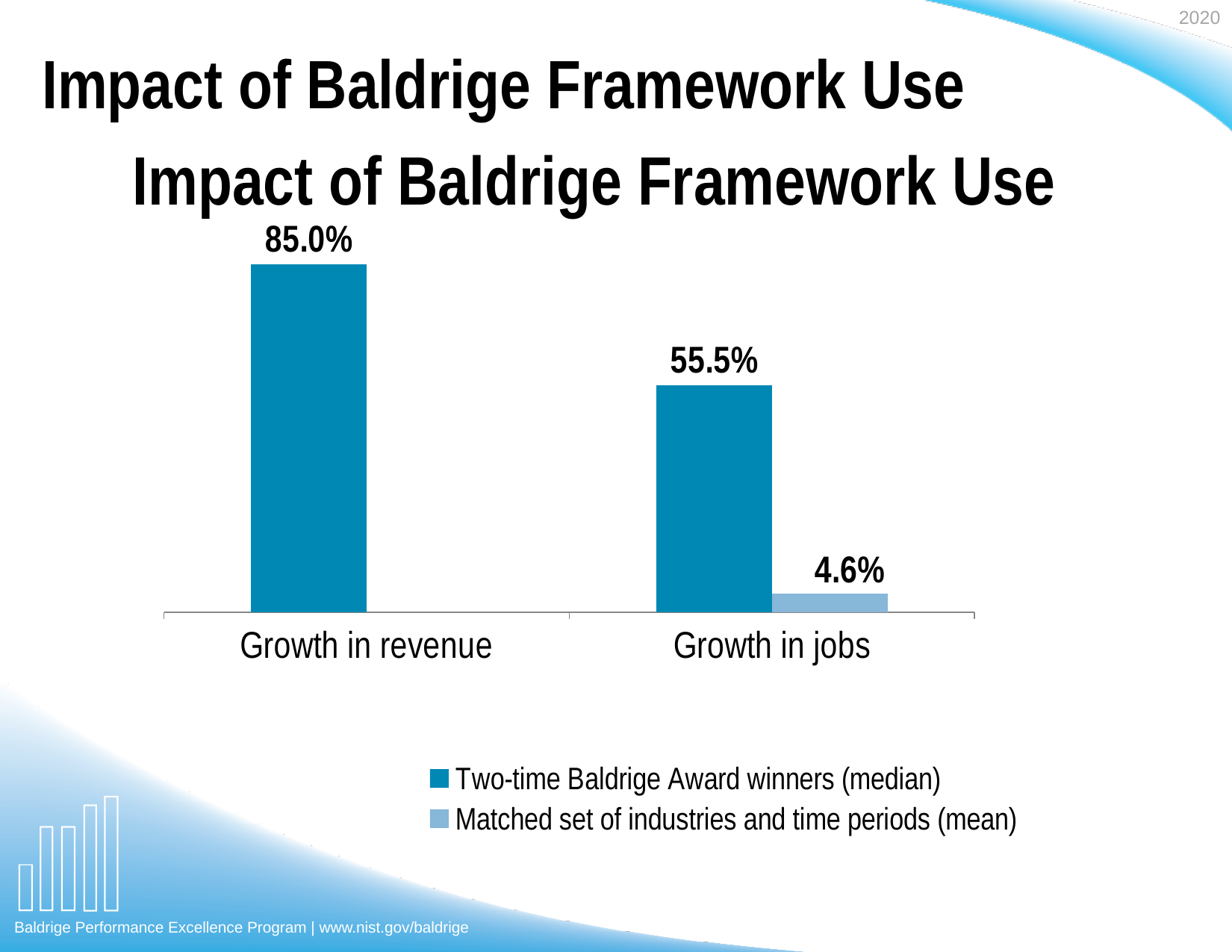
For Growth in jobs, what is the difference between the Two-time Baldrige Award winners (median) value and the Matched set of industries and time periods (mean) value? 50.9% What kind of chart is shown on the slide? Bar chart How many series does the legend list? 2 Which bar has the lowest value on the chart? Matched set of industries and time periods (mean), Growth in jobs What is the value for Two-time Baldrige Award winners (median) for Growth in revenue? 85.0% For Two-time Baldrige Award winners (median), what is the difference between Growth in revenue and Growth in jobs? 29.5% How many categories are shown on the x axis? 2 What is the value for Matched set of industries and time periods (mean) for Growth in jobs? 4.6% Which bar has the highest value on the chart? Two-time Baldrige Award winners (median), Growth in revenue For Two-time Baldrige Award winners (median), which is larger: Growth in revenue or Growth in jobs? Growth in revenue What is the title of the chart? Impact of Baldrige Framework Use What is the value for Two-time Baldrige Award winners (median) for Growth in jobs? 55.5%